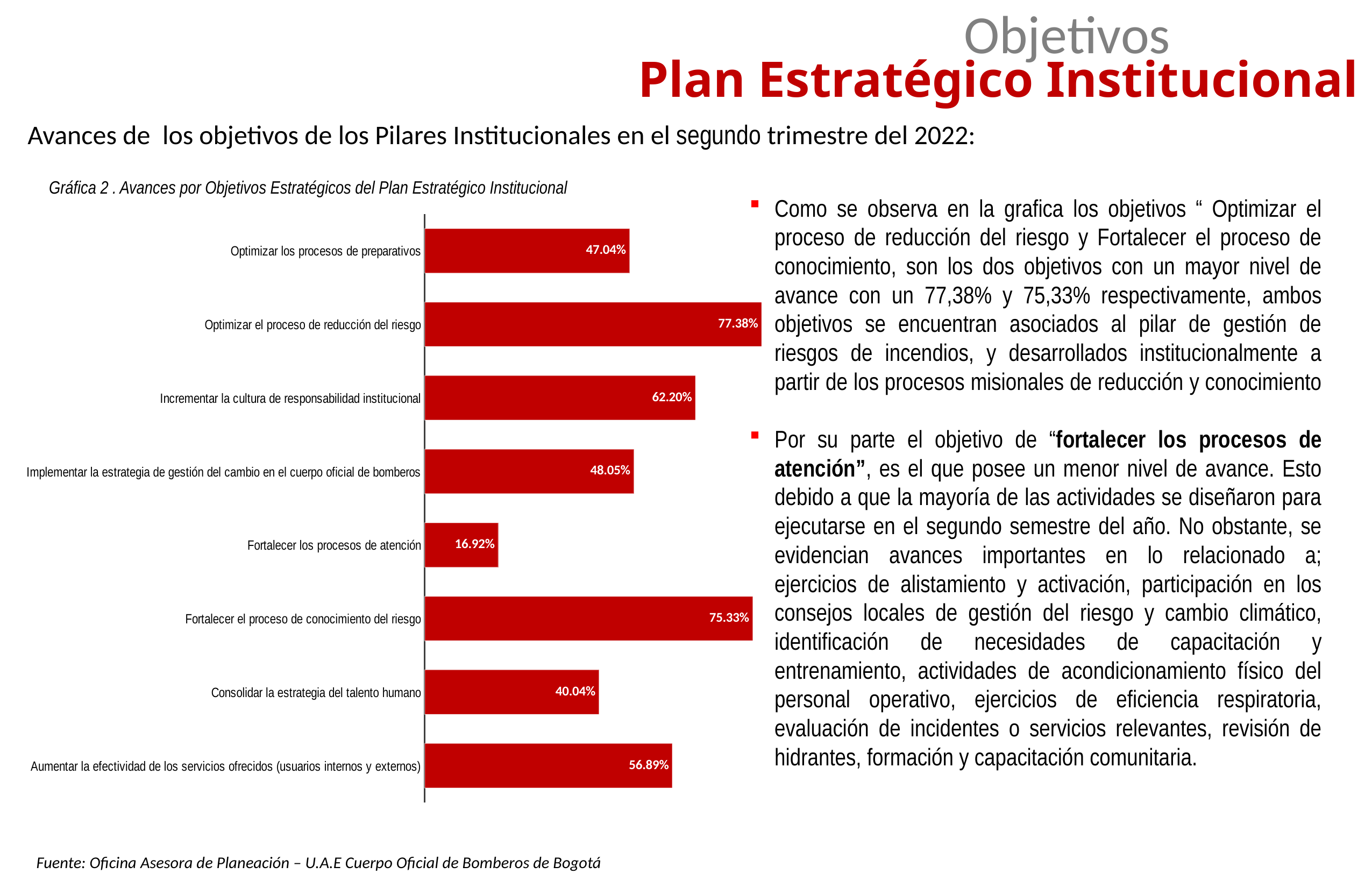
What is the value for "Optimizar el proceso de reducción del riesgo"? 77.38% What is the value for "Fortalecer los procesos de atención"? 16.92% What colour are the bars in the chart? Red What is the title of the chart (Gráfica 2)? Avances por Objetivos Estratégicos del Plan Estratégico Institucional How many objectives (bars) are shown in the chart? 8 Which objective has the lowest value? Fortalecer los procesos de atención What kind of chart is shown on the slide? Bar chart Which is larger: the value for "Incrementar la cultura de responsabilidad institucional" or the value for "Implementar la estrategia de gestión del cambio en el cuerpo oficial de bomberos"? Incrementar la cultura de responsabilidad institucional What is the difference between the values for "Optimizar el proceso de reducción del riesgo" and "Fortalecer el proceso de conocimiento del riesgo"? 2.05% What is the value for "Consolidar la estrategia del talento humano"? 40.04% What is the value for "Aumentar la efectividad de los servicios ofrecidos (usuarios internos y externos)"? 56.89% Which objective has the highest value? Optimizar el proceso de reducción del riesgo